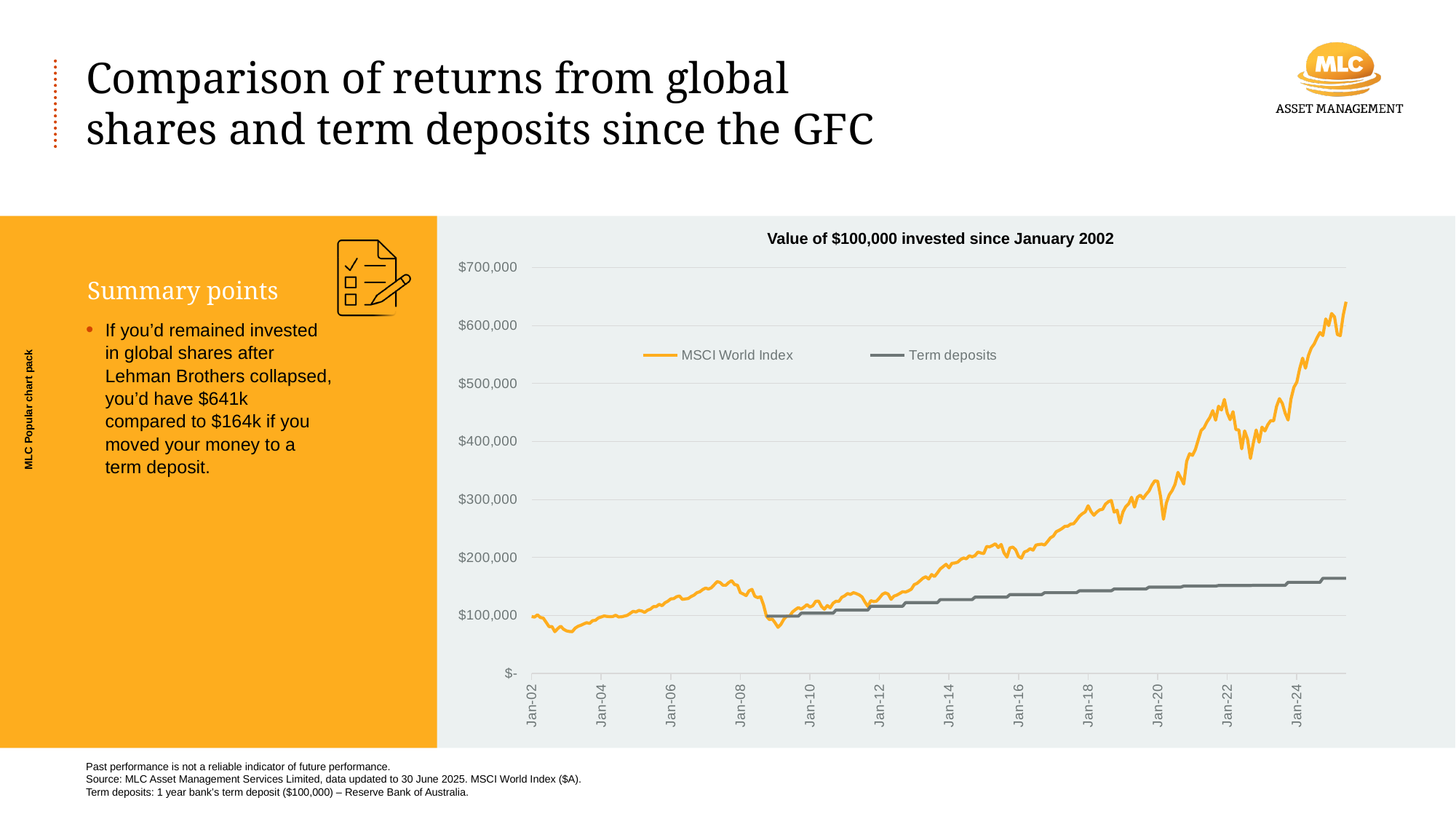
At Jan-24, which series has the higher value, MSCI World Index or Term deposits? MSCI World Index Is the value of the MSCI World Index line at Jan-16 greater or less than $300,000? less What kind of chart is shown on the slide? line chart Is the value of the Term deposits line at Jan-24 greater or less than $200,000? less What colour is the MSCI World Index line in the chart? orange Does the Term deposits line rise or fall from left to right across the chart? rise Is the value of the MSCI World Index line at Jan-24 greater or less than $400,000? greater How many date labels are shown on the x axis of the chart? 12 What is the title of the chart? Value of $100,000 invested since January 2002 Which series reaches the highest value on the chart? MSCI World Index How many series does the chart legend list? 2